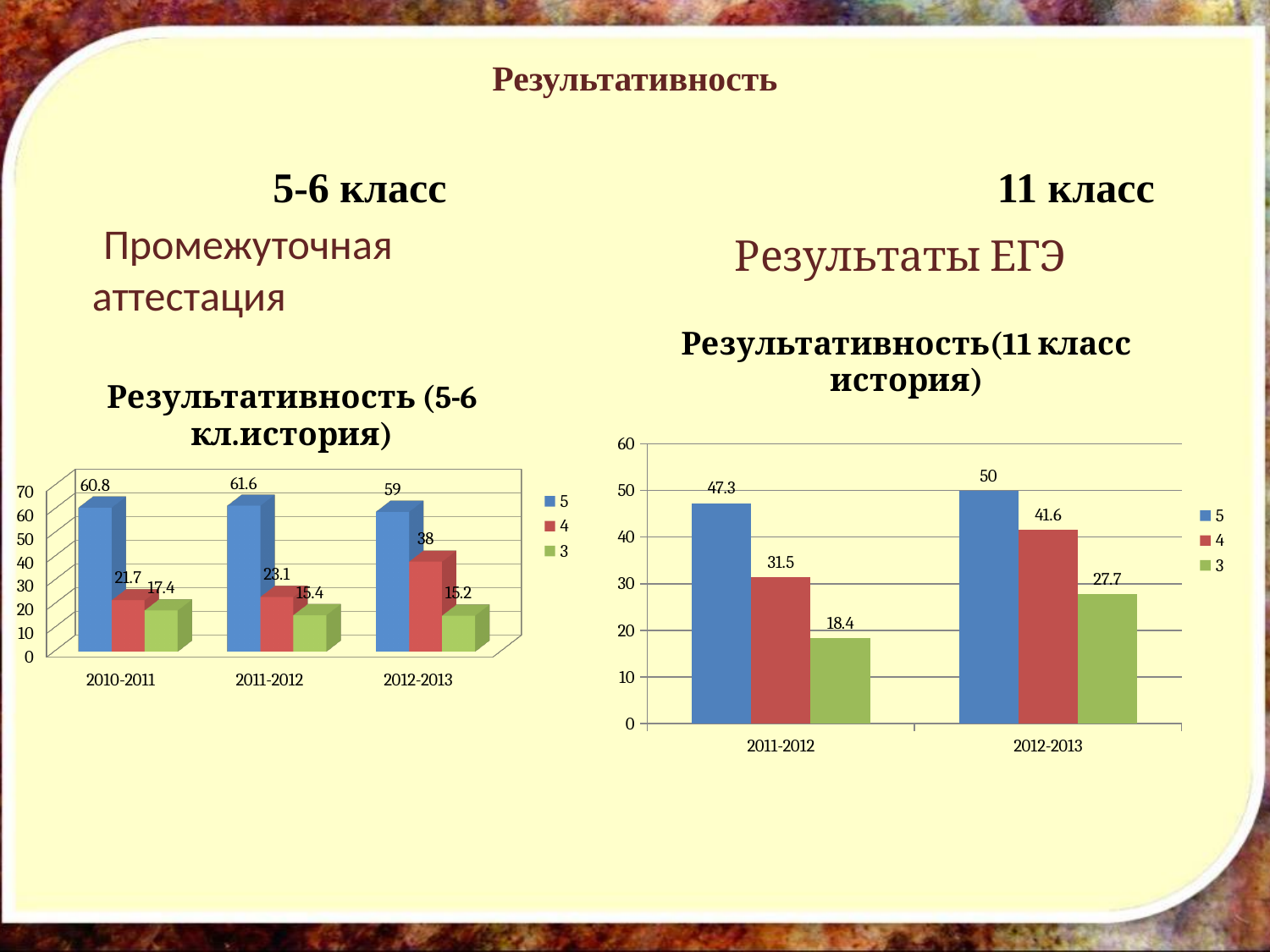
In the left chart (Результативность (5-6 кл.история)), what is the value of series 5 for 2010-2011? 60.8 In the left chart (Результативность (5-6 кл.история)), what is the value of series 4 for 2012-2013? 38 In the left chart (Результативность (5-6 кл.история)), which category has the lowest value for series 3? 2012-2013 In the right chart (Результативность(11 класс история)), what is the value of series 3 for 2012-2013? 27.7 In the right chart (Результативность(11 класс история)), how many series does the legend list? 3 In the left chart (Результативность (5-6 кл.история)), which category has the highest value for series 5? 2011-2012 In the right chart (Результативность(11 класс история)), what is the difference between series 3 in 2012-2013 and series 3 in 2011-2012? 9.3 In the right chart (Результативность(11 класс история)), which is larger: series 5 in 2011-2012 or series 5 in 2012-2013? 2012-2013 In the left chart (Результативность (5-6 кл.история)), what is the difference between series 4 in 2012-2013 and series 4 in 2011-2012? 14.9 What kind of chart is the right chart (Результативность(11 класс история))? Bar chart In the left chart (Результативность (5-6 кл.история)), how many categories are shown on the x axis? 3 In the right chart (Результативность(11 класс история)), what is the value of series 4 for 2011-2012? 31.5